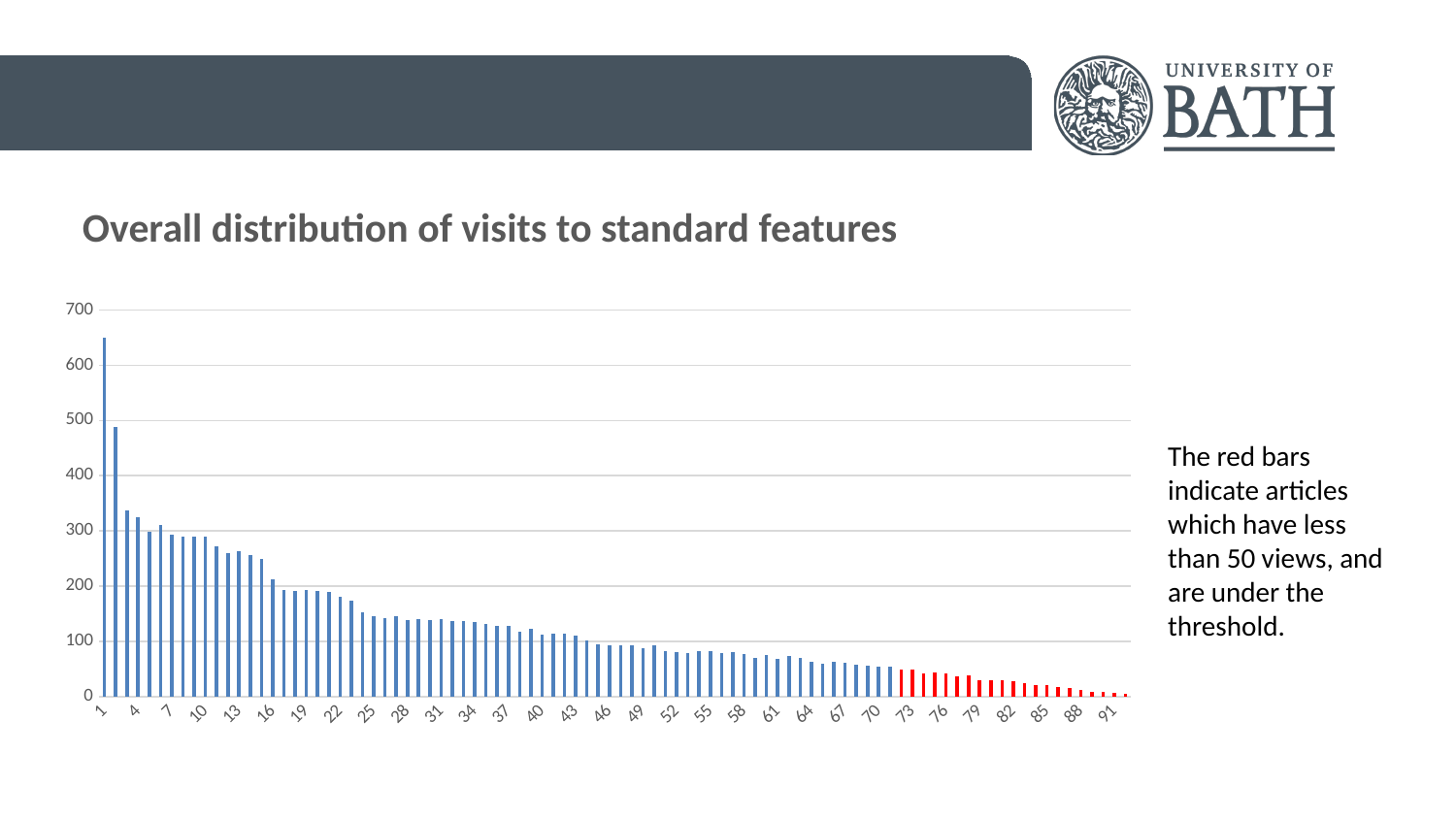
Which category has the highest bar? 1 Is the value for category 79 greater or less than 50? less Is the value for category 22 greater or less than 200? less Is the value for category 13 greater or less than 200? greater Do the bar values rise or fall moving from left to right along the x axis? fall Which has the larger value, category 1 or category 4? 1 What kind of chart is shown on the slide? bar chart What colour are the bars for articles with fewer than 50 views? red What is the title of the chart? Overall distribution of visits to standard features